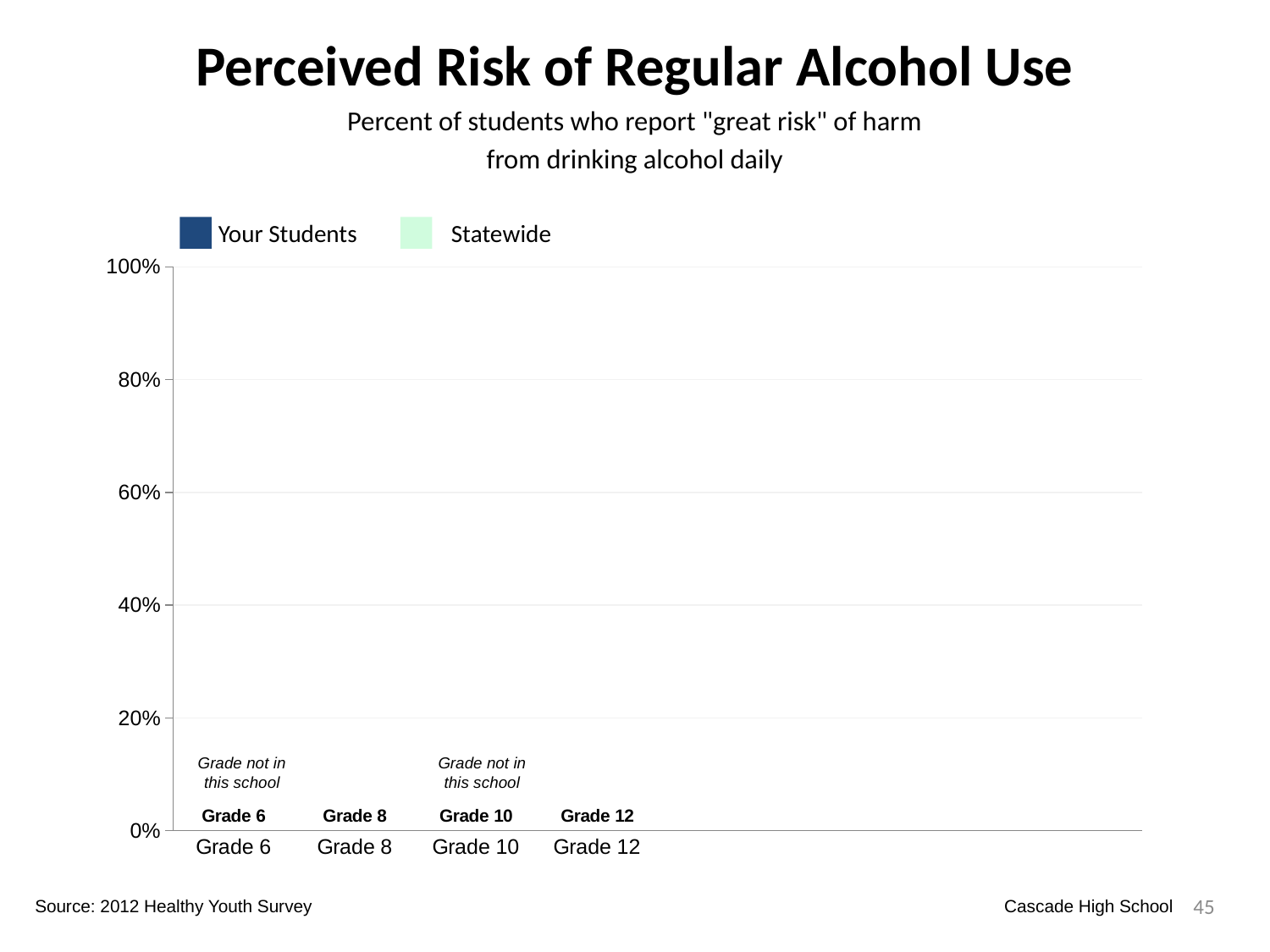
What is the title of the chart? Perceived Risk of Regular Alcohol Use What are the two series named in the chart's legend? Your Students and Statewide What is the highest value shown on the chart's y axis? 100% What is the last category on the x axis of the chart? Grade 12 What is the first category on the x axis of the chart? Grade 6 How many grade categories are shown on the x axis of the chart? 4 Which grades are marked "Grade not in this school" on the chart? Grade 6 and Grade 10 How many series does the chart's legend list? 2